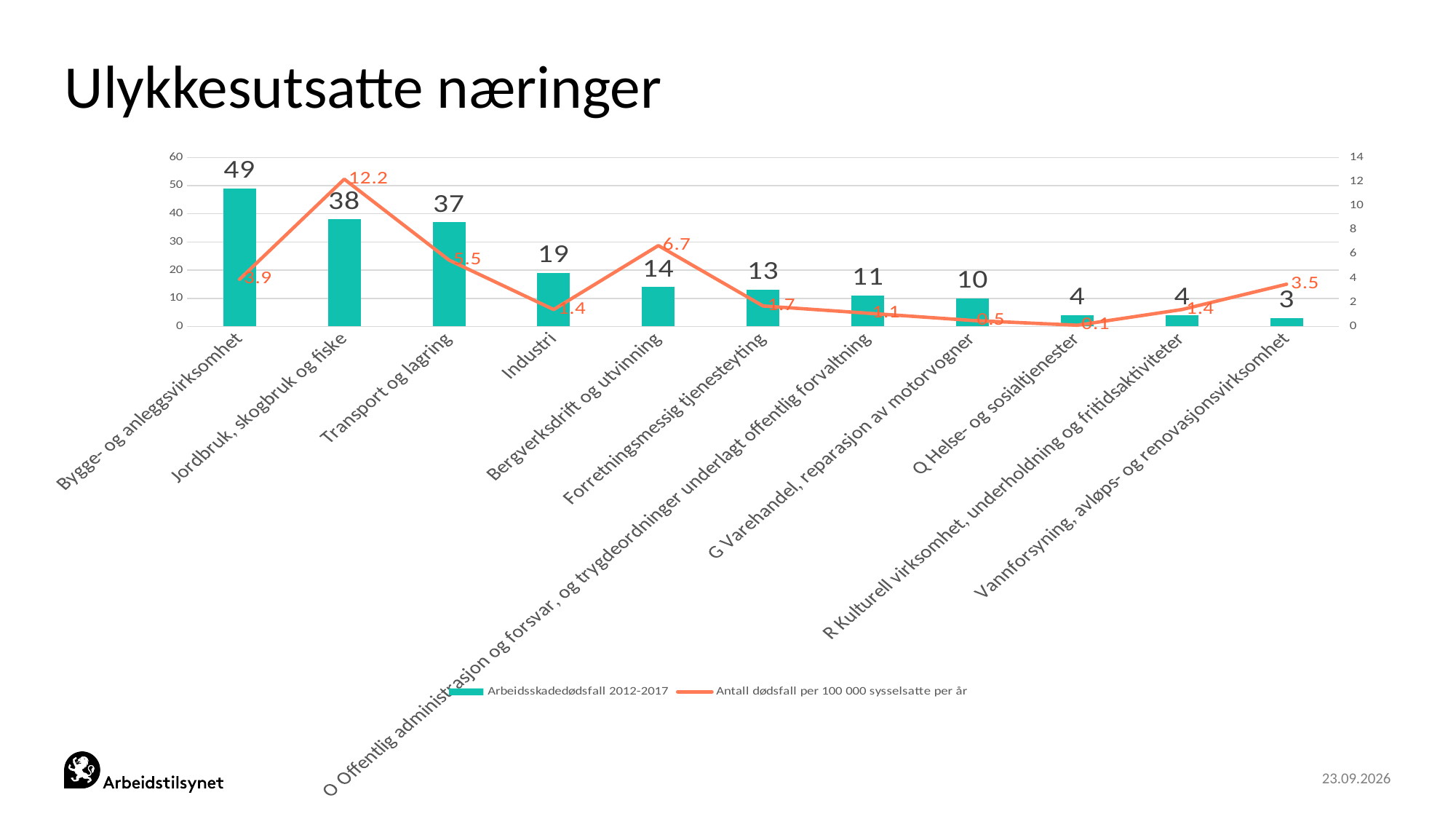
What is the difference in Arbeidsskadedødsfall 2012-2017 between Bygge- og anleggsvirksomhet and Jordbruk, skogbruk og fiske? 11 Which category has the highest value of Antall dødsfall per 100 000 sysselsatte per år? Jordbruk, skogbruk og fiske Which category has the lowest value of Arbeidsskadedødsfall 2012-2017? Vannforsyning, avløps- og renovasjonsvirksomhet What is the title of the slide? Ulykkesutsatte næringer What is the value of Antall dødsfall per 100 000 sysselsatte per år for Jordbruk, skogbruk og fiske? 12.2 How many series does the legend list? 2 How many industry categories are shown on the x axis? 11 What is the value of Arbeidsskadedødsfall 2012-2017 for Industri? 19 What kind of chart is shown on the slide? A combined bar and line chart Which has the larger value of Antall dødsfall per 100 000 sysselsatte per år: Bergverksdrift og utvinning or Industri? Bergverksdrift og utvinning Which category has the highest value of Arbeidsskadedødsfall 2012-2017? Bygge- og anleggsvirksomhet What is the value of Arbeidsskadedødsfall 2012-2017 for Bygge- og anleggsvirksomhet? 49